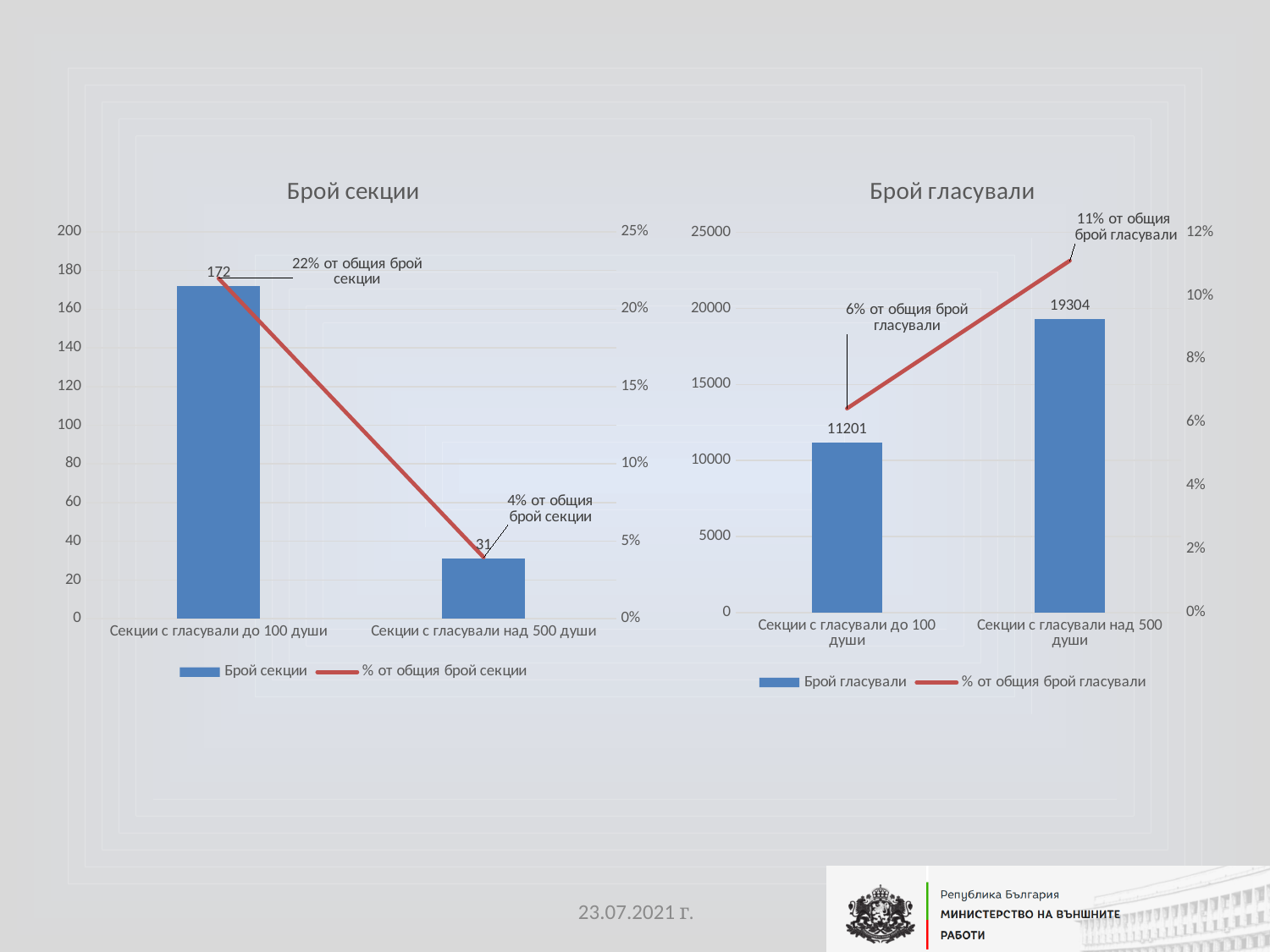
In the 'Брой секции' chart, is the value for 'Секции с гласували до 100 души' greater or less than 160? greater In the 'Брой гласували' chart, what is the value of 'Брой гласували' for 'Секции с гласували над 500 души'? 19304 In the 'Брой секции' chart, what is the value of 'Брой секции' for 'Секции с гласували над 500 души'? 31 How many series does the legend of the 'Брой гласували' chart list? 2 In the 'Брой секции' chart, does the '% от общия брой секции' line rise or fall from left to right? fall In the 'Брой гласували' chart, what percentage of the total number of voters do 'Секции с гласували до 100 души' represent? 6% In the 'Брой гласували' chart, which category has the higher number of voters? Секции с гласували над 500 души In the 'Брой гласували' chart, what is the value of 'Брой гласували' for 'Секции с гласували до 100 души'? 11201 In the 'Брой гласували' chart, what is the difference in the number of voters between 'Секции с гласували над 500 души' and 'Секции с гласували до 100 души'? 8103 In the 'Брой секции' chart, what is the difference between the number of sections for 'Секции с гласували до 100 души' and 'Секции с гласували над 500 души'? 141 In the 'Брой секции' chart, what percentage of the total number of sections do 'Секции с гласували над 500 души' represent? 4% In the 'Брой секции' chart, what is the value of 'Брой секции' for 'Секции с гласували до 100 души'? 172